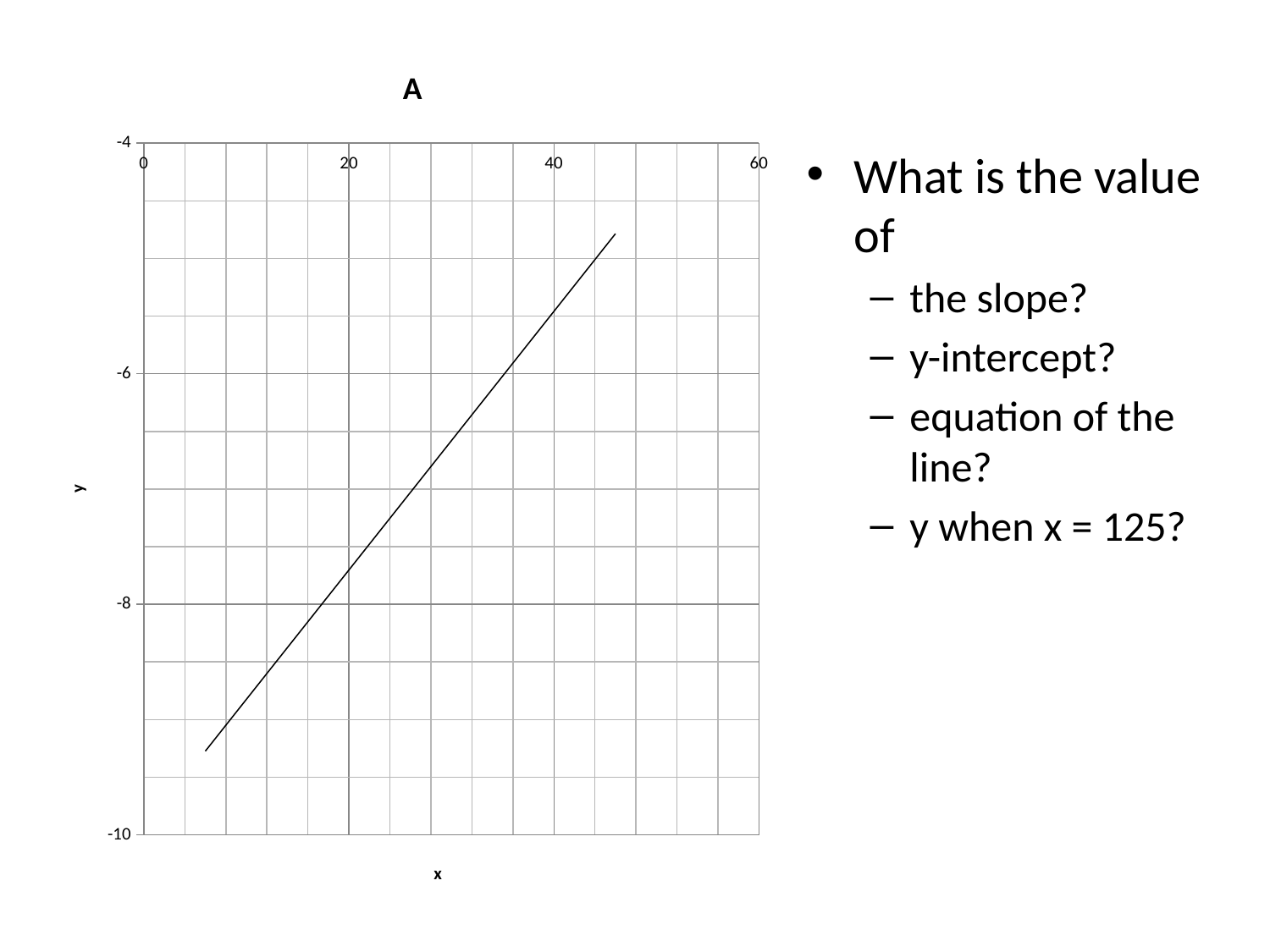
What is the largest value labelled on the x axis? 60 Does the line rise or fall as x increases? rises Is the value of y at x = 20 greater or less than -8? greater Is the value of y at x = 30 greater or less than -8? greater What kind of chart is shown on the slide? line chart What is the title of the chart? A What is the label on the horizontal axis of the chart? x Is the value of y at x = 40 greater or less than -4? less Is y at x = 40 larger or smaller than y at x = 10? larger